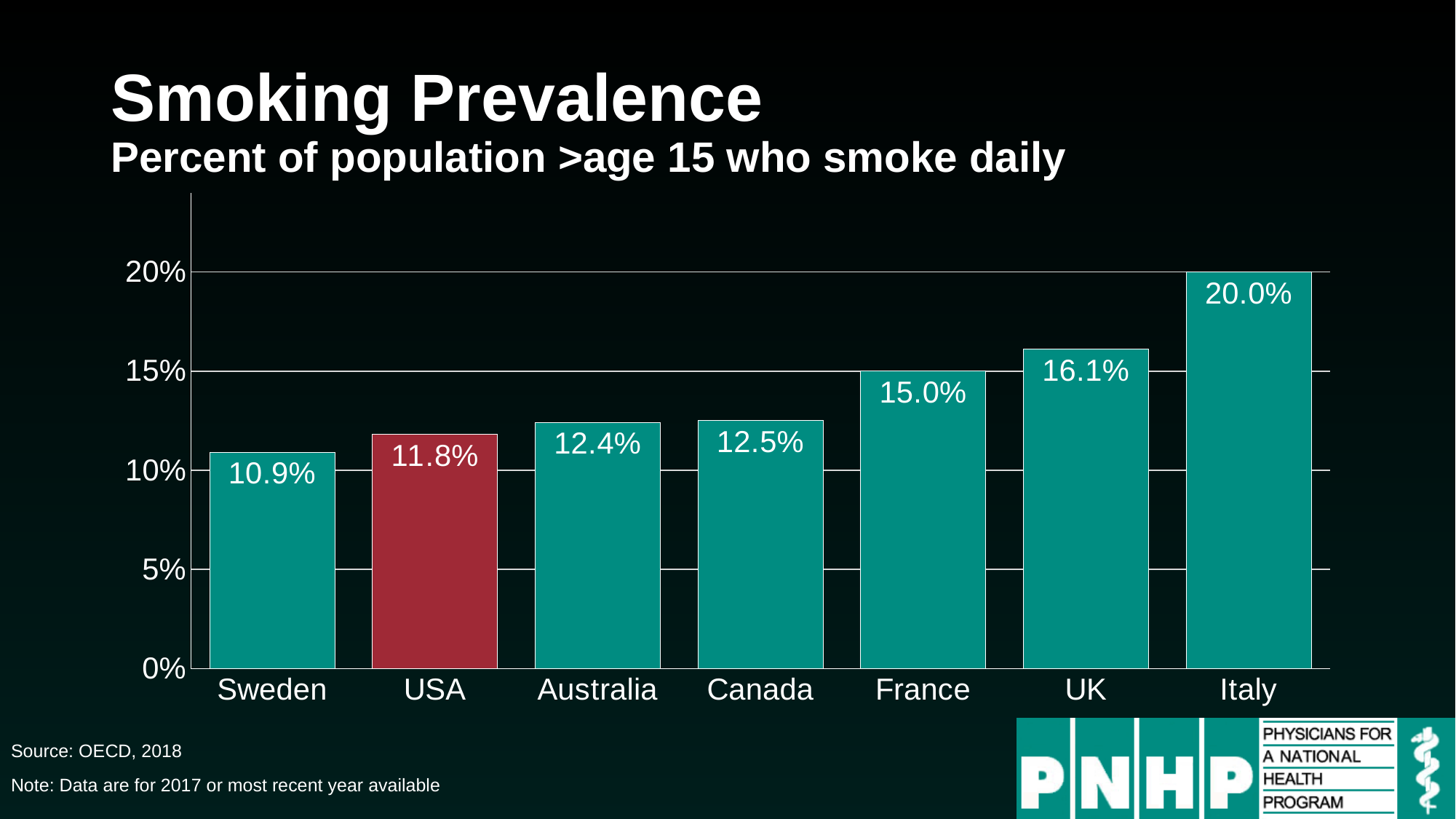
What is the difference in smoking prevalence between the UK and the USA? 4.3% What is the smoking prevalence shown for the USA? 11.8% Is the value for Canada greater or less than 15%? less What is the smoking prevalence shown for the UK? 16.1% Which has a higher smoking prevalence, France or Australia? France Which country has the highest smoking prevalence on the chart? Italy How many countries are shown on the chart? 7 Which country has the lowest smoking prevalence on the chart? Sweden What is the difference in smoking prevalence between Italy and Sweden? 9.1% What is the smoking prevalence shown for France? 15.0% What kind of chart is shown on the slide? Bar chart Which country's bar is shown in a different colour (red) from the others? USA